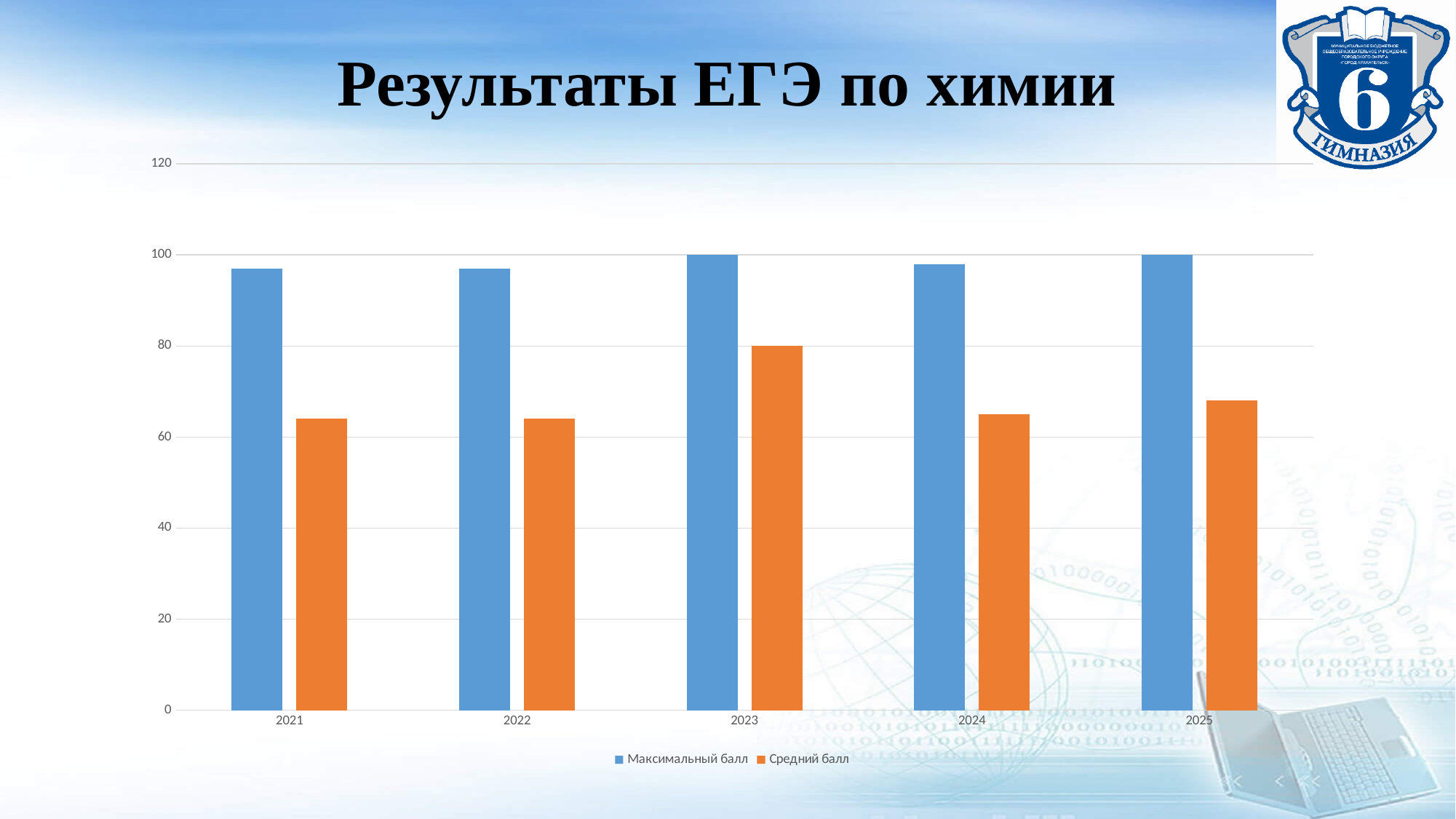
How many years are shown on the x axis? 5 What is the value of Максимальный балл for 2023? 100 Is the value of Средний балл for 2021 greater or less than 60? greater What is the title of the chart? Результаты ЕГЭ по химии Is the value of Максимальный балл for 2024 greater or less than 80? greater How many series does the legend list? 2 Which year has the highest Средний балл? 2023 What is the value of Максимальный балл for 2025? 100 What kind of chart is shown on the slide? bar chart Which is larger: Средний балл for 2023 or Средний балл for 2024? 2023 Is the value of Средний балл for 2022 greater or less than 80? less What is the value of Средний балл for 2023? 80